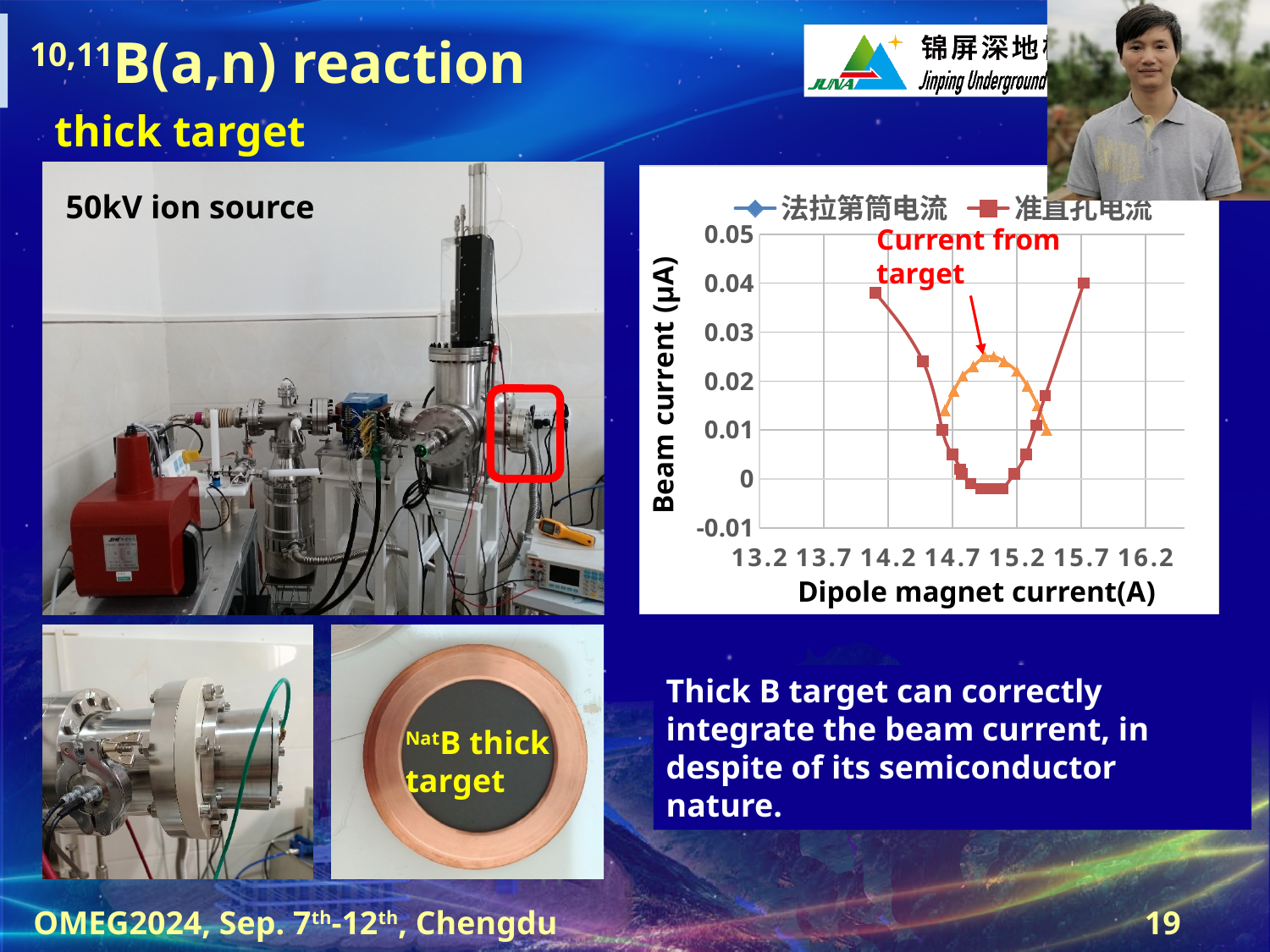
Does the 准直孔电流 series rise or fall between 14.2 and 14.7 on the x axis? fall How many series does the chart legend list? 2 Is the lowest value of the 准直孔电流 series greater or less than 0.01? less Is the highest value of the 准直孔电流 series greater or less than 0.03? greater Does the 准直孔电流 series rise or fall between 15.2 and 15.7 on the x axis? rise What kind of chart is shown on the slide? line chart What is the title of the x axis of the chart? Dipole magnet current(A) Which is larger for the 准直孔电流 series: the value at 14.2 or the value at 14.7? 14.2 Is the peak of the 'Current from target' series greater or less than 0.02? greater What is the lowest value shown on the y axis of the chart? -0.01 What is the title of the y axis of the chart? Beam current (μA)